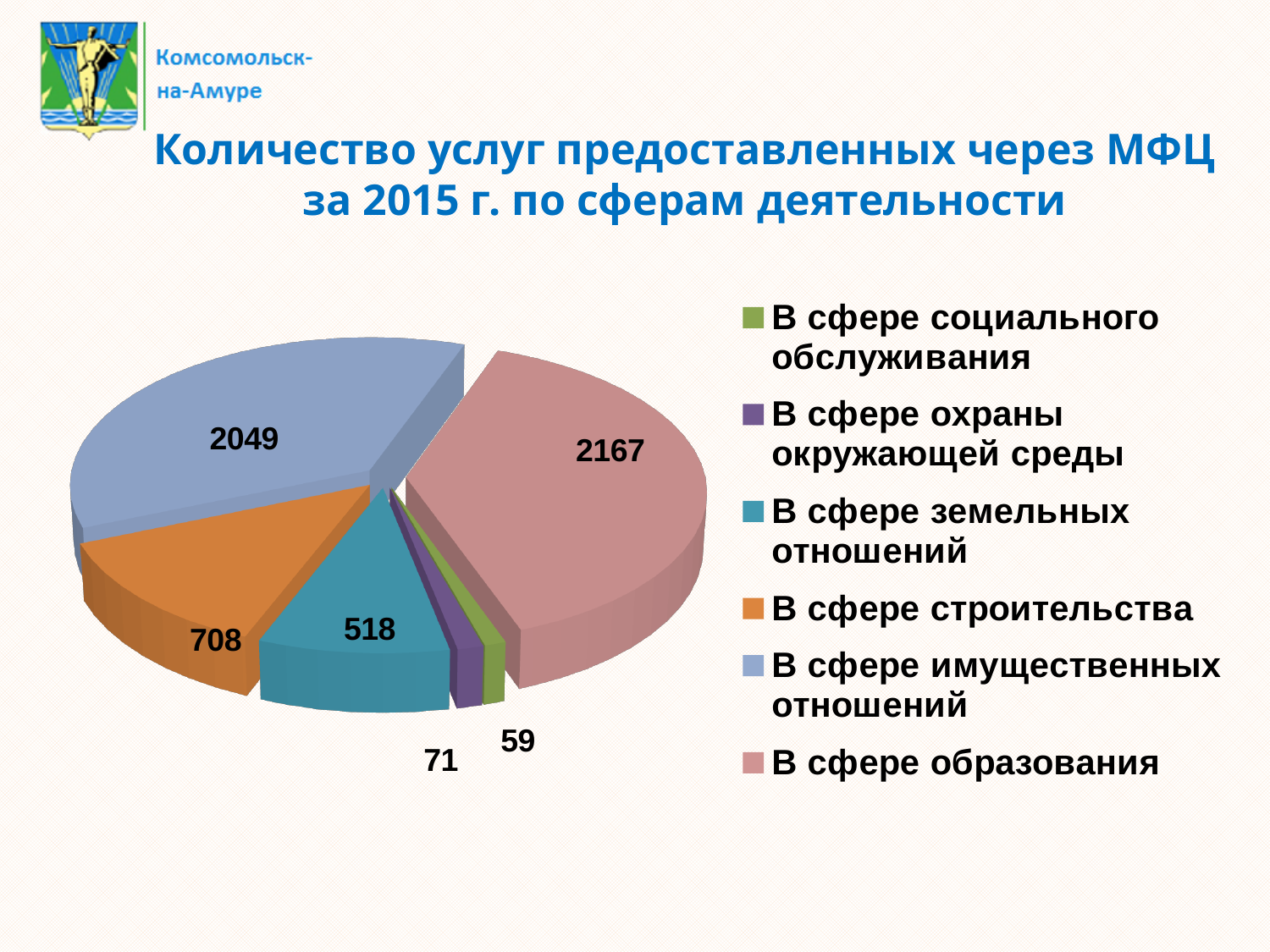
Which sphere has the smallest number of services provided? В сфере социального обслуживания What is the value for the sphere of land relations (В сфере земельных отношений)? 518 What is the value for the sphere of social services (В сфере социального обслуживания)? 59 Which is larger: the value for construction or the value for land relations? В сфере строительства What is the total number of services across all slices of the pie chart? 5572 Which sphere has the largest number of services provided? В сфере образования How many categories (slices) does the pie chart have? 6 How many services were provided in the sphere of property relations (В сфере имущественных отношений)? 2049 What type of chart is shown on the slide? Pie chart How many services were provided in the sphere of education (В сфере образования)? 2167 What is the difference between the values for education (2167) and property relations (2049)? 118 What is the value for the sphere of construction (В сфере строительства)? 708